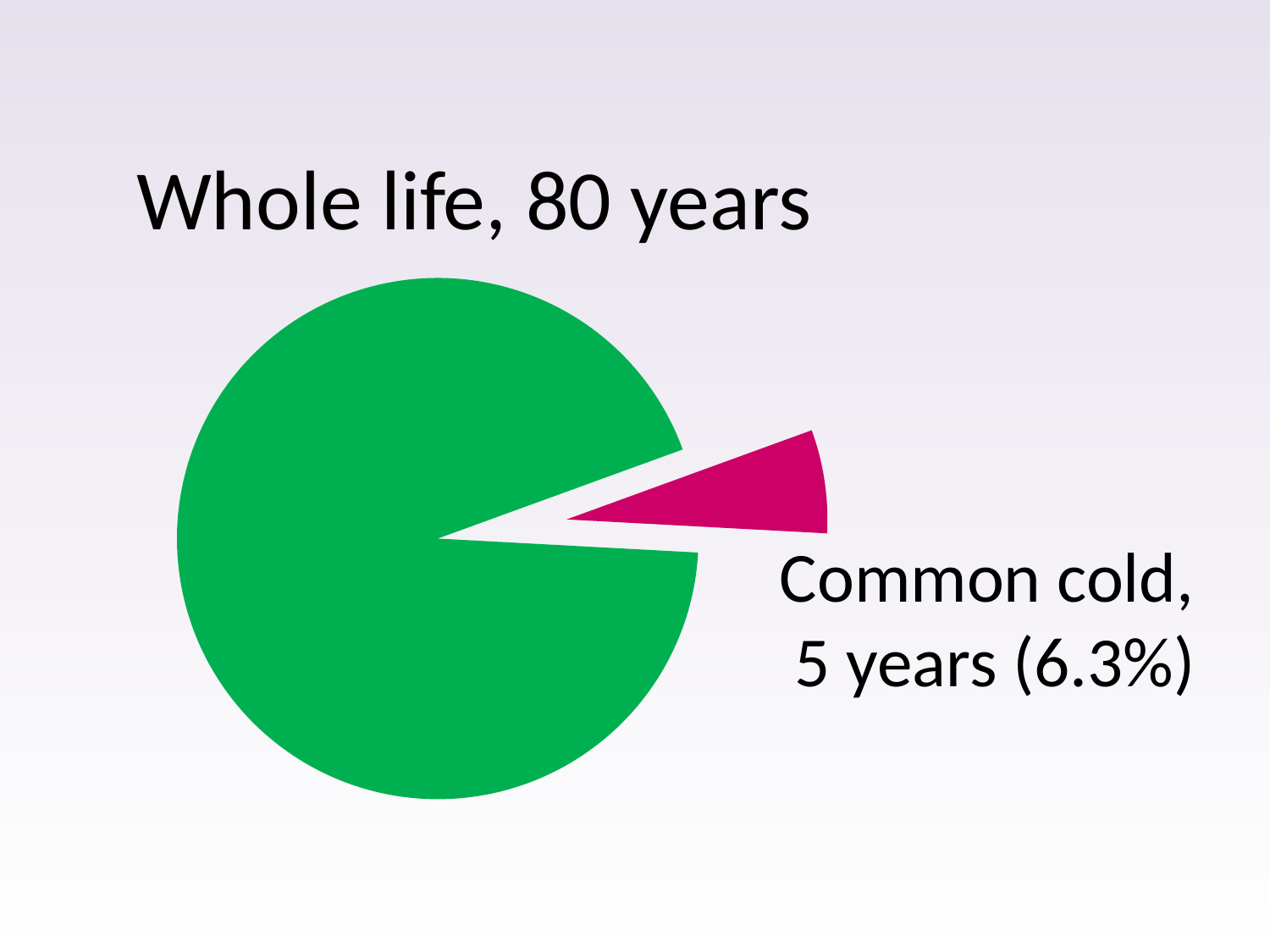
What percentage share of the pie does the Common cold slice represent? 6.3% How many years are shown for the Whole life slice? 80 years What colour is the Whole life slice? green How many years are shown for the Common cold slice? 5 years What kind of chart is shown on the slide? pie chart Which slice of the pie chart is the smallest? Common cold How many slices does the pie chart have? 2 Which is larger, the Whole life slice or the Common cold slice? Whole life What colour is the Common cold slice? magenta What is the difference in years between the Whole life slice and the Common cold slice? 75 years Which slice of the pie chart is the largest? Whole life